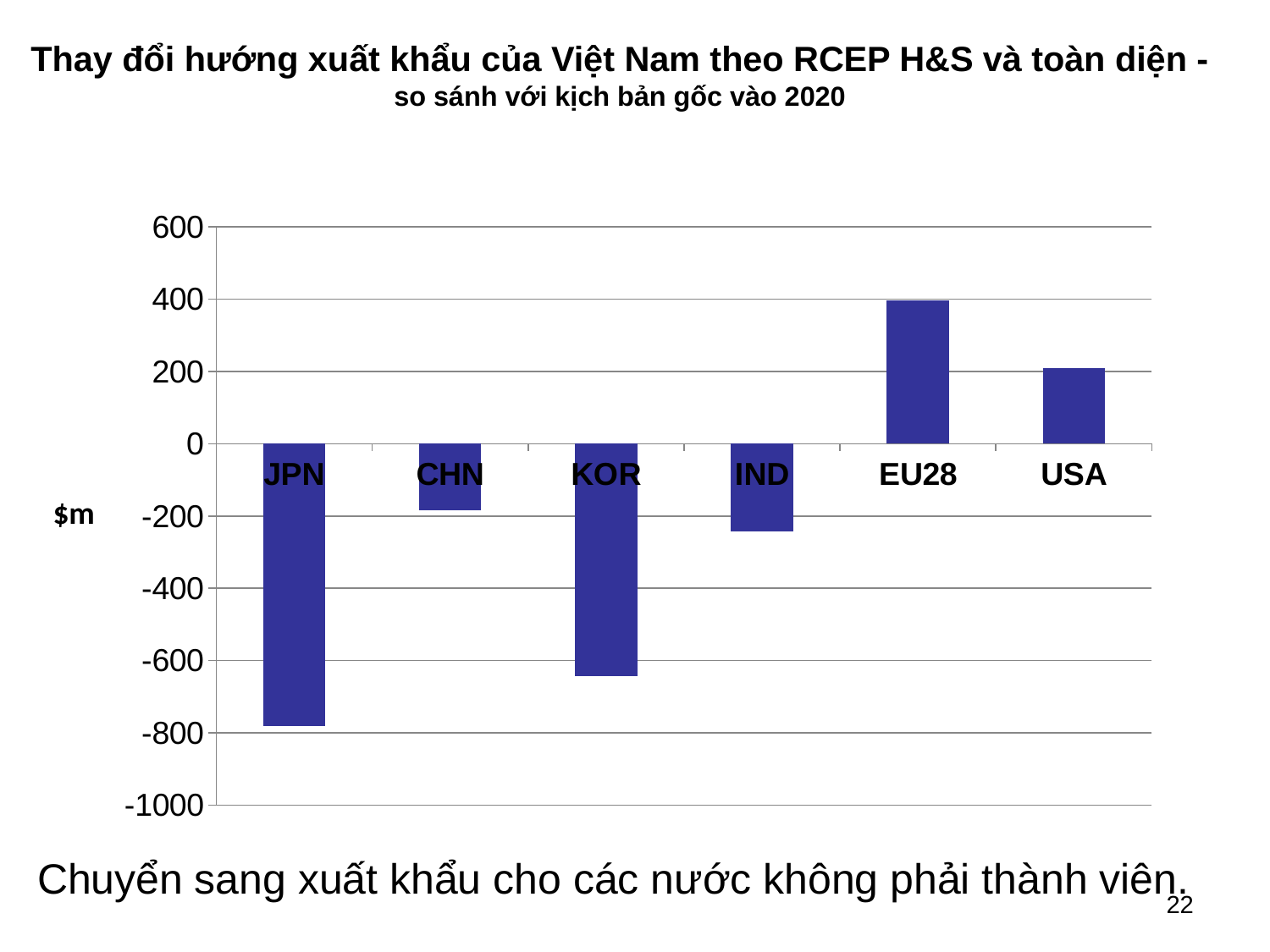
Is the value for USA greater or less than 400? less What unit label is shown on the y axis of the chart? $m Which has the larger value, JPN or KOR? KOR Which category has the highest value in the chart? EU28 Is the value for CHN greater or less than -400? greater Which categories in the chart have positive values? EU28 and USA What kind of chart is shown on the slide? bar chart Is the value for JPN greater or less than -600? less Which category has the lowest value in the chart? JPN How many categories are shown on the x axis of the chart? 6 Which has the larger value, EU28 or USA? EU28